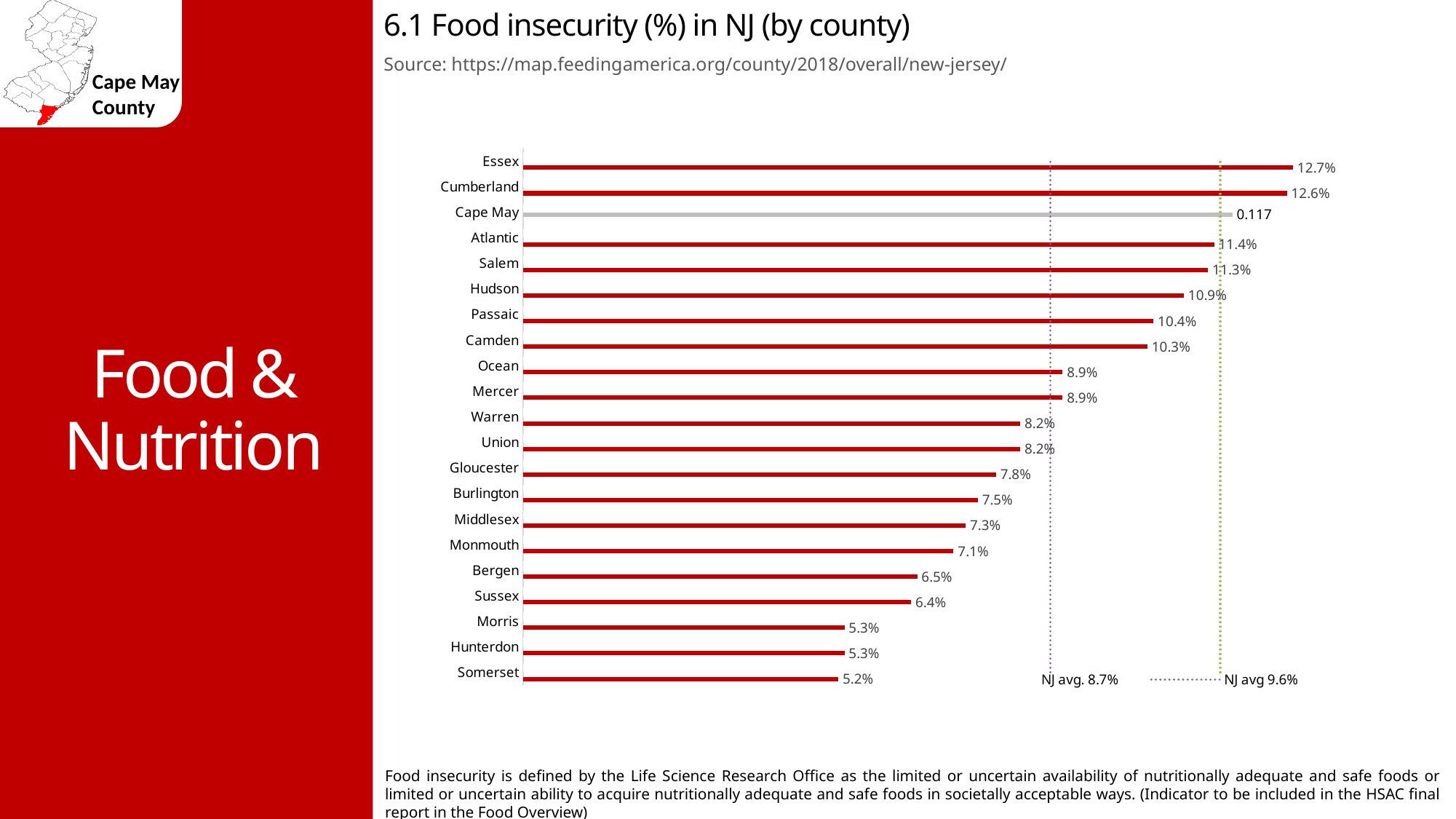
How many counties are shown in the chart? 21 What is the food insecurity value shown for Bergen? 6.5% What type of chart is shown on the slide? Bar chart What is the food insecurity value shown for Hudson? 10.9% Which county has the highest food insecurity value? Essex Which has a higher food insecurity value, Hudson or Passaic? Hudson What is the difference between the values for Passaic and Camden? 0.1% What is the food insecurity value shown for Essex? 12.7% What NJ average values are marked by the dotted vertical lines? NJ avg. 8.7% and NJ avg 9.6% What value is labeled on the Cape May bar? 0.117 Which county has the lowest food insecurity value? Somerset What is the difference between the values for Essex and Somerset? 7.5%